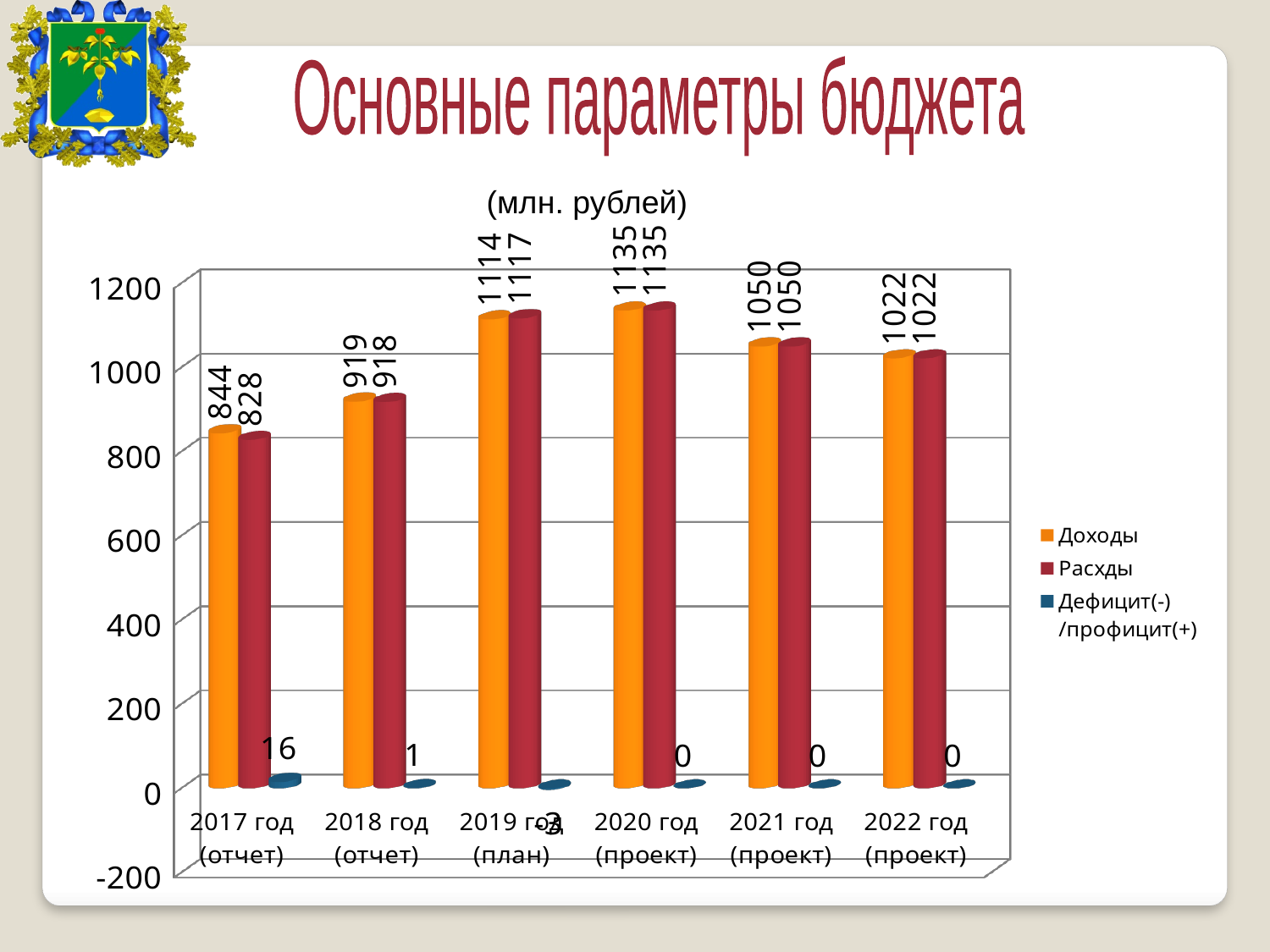
Which is larger for 2019 год (план): Доходы or Расхды? Расхды What is the difference between Доходы and Расхды for 2017 год (отчет)? 16 What kind of chart is shown on the slide? bar chart Which year has the highest value of Доходы? 2020 год (проект) What is the value of Дефицит(-)/профицит(+) for 2017 год (отчет)? 16 How many series does the legend list? 3 What unit is given under the chart title? млн. рублей How many years are shown on the x axis? 6 Which year has the lowest value of Расхды? 2017 год (отчет) What is the value of Расхды for 2019 год (план)? 1117 What is the value of Доходы for 2017 год (отчет)? 844 Is the value of Доходы for 2018 год (отчет) greater or less than 1000? less